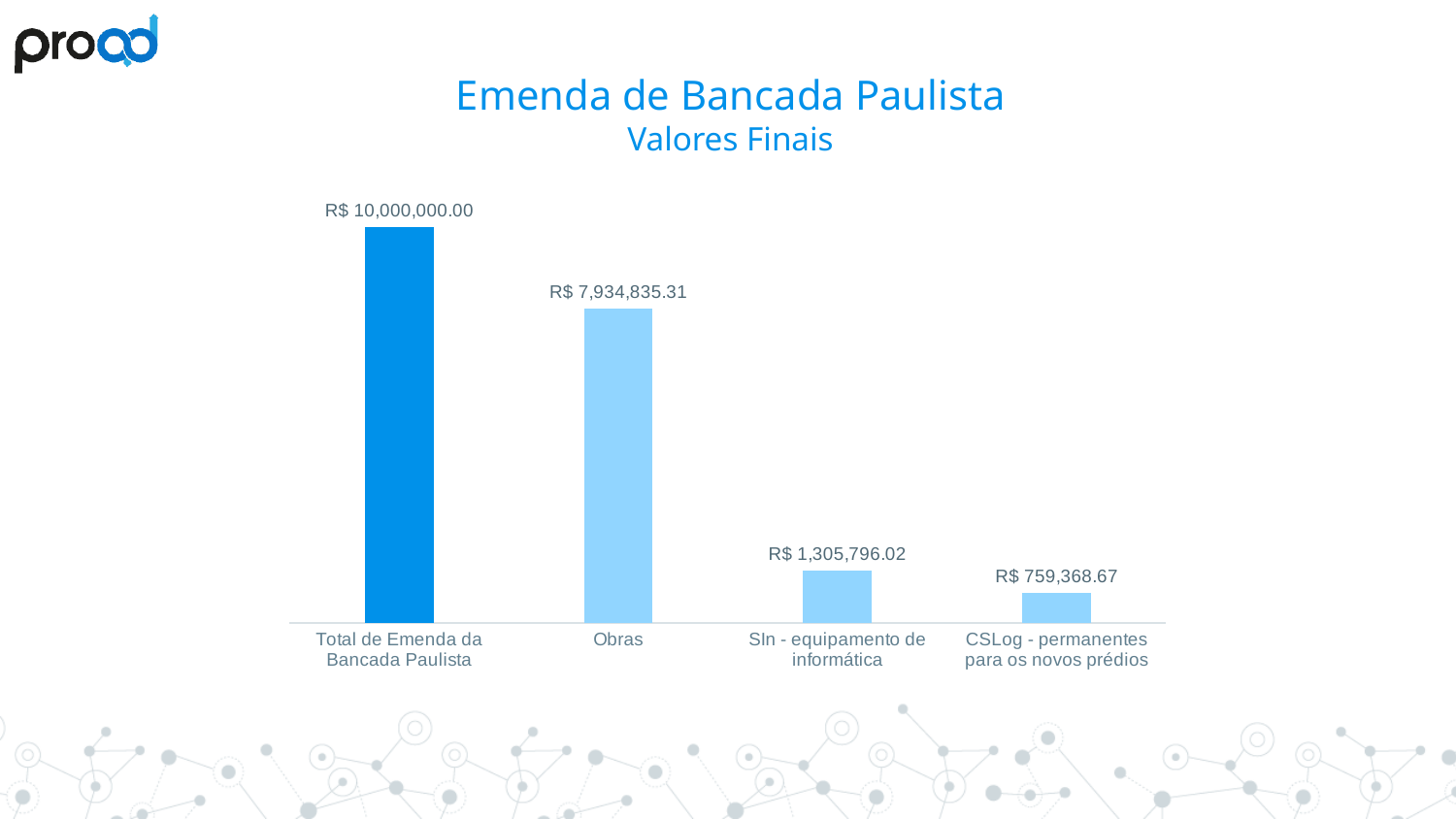
What is the value for SIn - equipamento de informática? R$ 1,305,796.02 What is the value for Obras? R$ 7,934,835.31 How many categories are shown in the chart? 4 Which category has the highest value? Total de Emenda da Bancada Paulista What is the difference between the value for SIn - equipamento de informática and the value for CSLog - permanentes para os novos prédios? R$ 546,427.35 What is the value for CSLog - permanentes para os novos prédios? R$ 759,368.67 Which is larger, the value for Obras or the value for SIn - equipamento de informática? Obras What is the title of the chart? Emenda de Bancada Paulista Valores Finais Which category has the lowest value? CSLog - permanentes para os novos prédios What is the value for Total de Emenda da Bancada Paulista? R$ 10,000,000.00 What kind of chart is shown on the slide? Bar chart What is the difference between the value for Total de Emenda da Bancada Paulista and the value for Obras? R$ 2,065,164.69